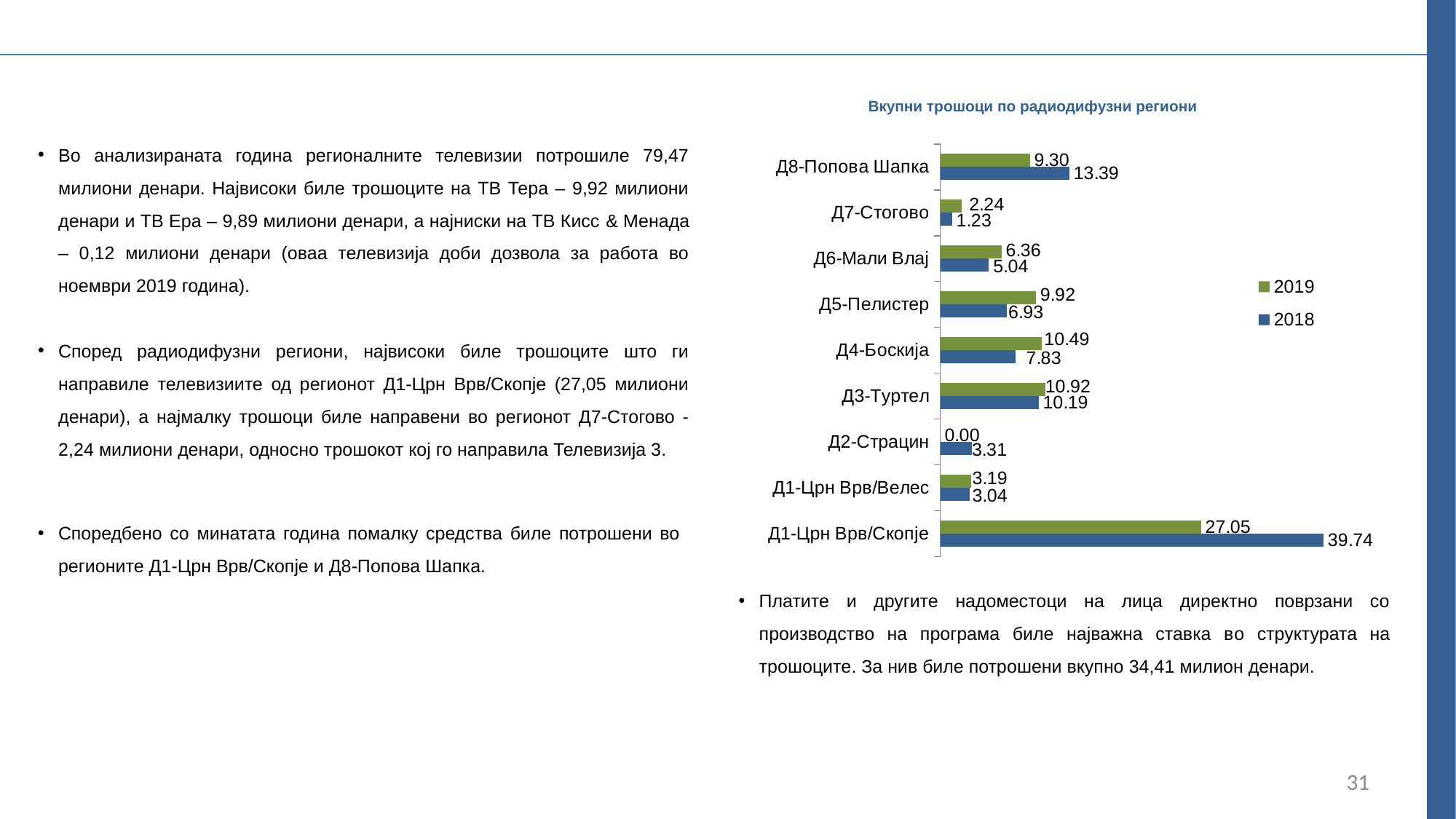
Which region has the lowest 2018 value? Д7-Стогово What is the 2018 value for Д8-Попова Шапка? 13.39 Which is larger for Д5-Пелистер, the 2019 value or the 2018 value? 2019 Which region has the highest 2018 value? Д1-Црн Врв/Скопје What is the title of the chart? Вкупни трошоци по радиодифузни региони What is the 2019 value for Д1-Црн Врв/Скопје? 27.05 What is the difference between the 2018 and 2019 values for Д1-Црн Врв/Скопје? 12.69 How many series does the legend list? 2 What is the 2019 value for Д2-Страцин? 0.00 Which is larger for Д8-Попова Шапка, the 2019 value or the 2018 value? 2018 What kind of chart is shown on the slide? Bar chart How many regions are shown on the chart? 9